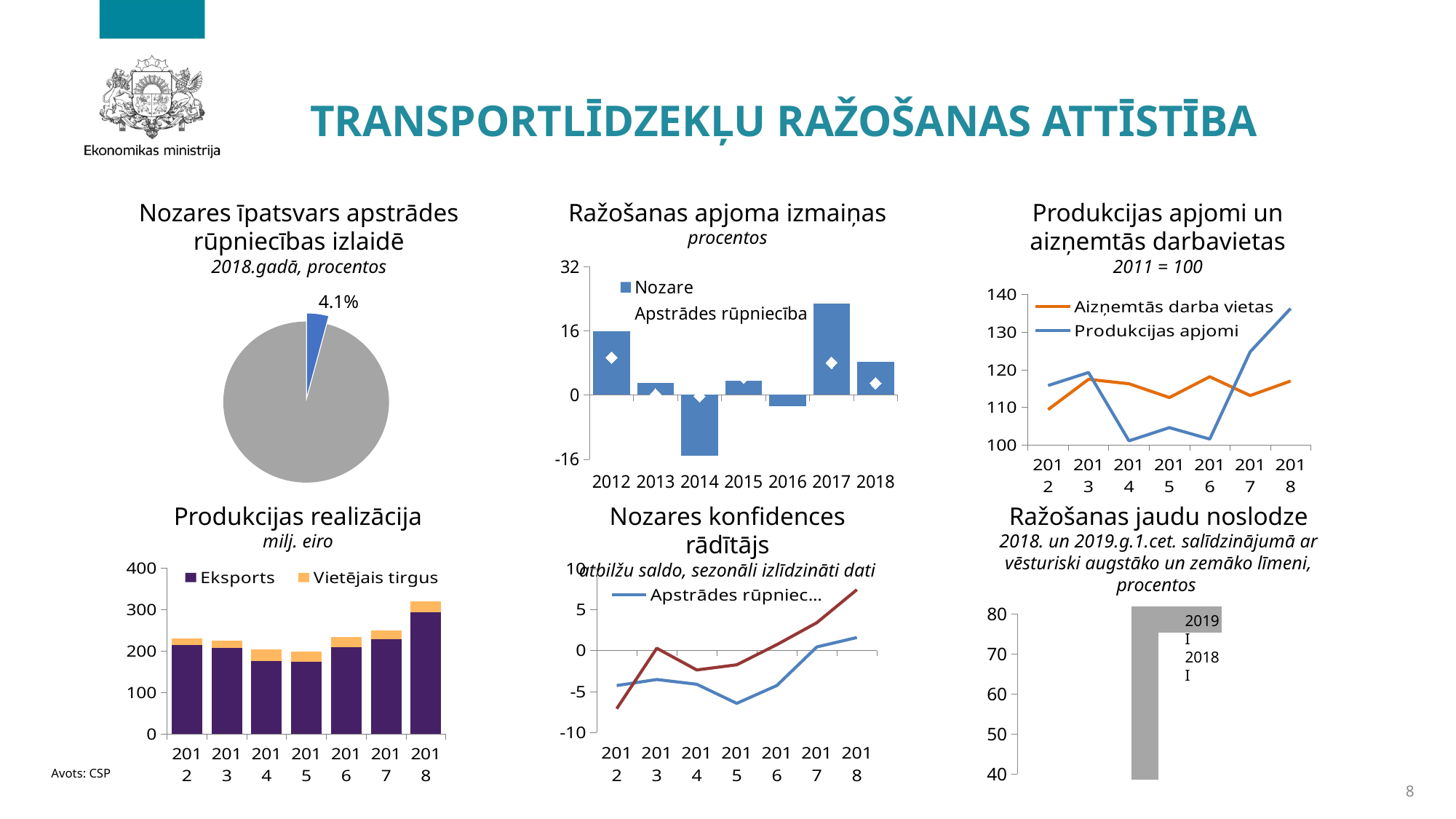
In the chart 'Ražošanas apjoma izmaiņas', how many years are shown on the x axis? 7 In the chart 'Produkcijas apjomi un aizņemtās darbavietas', which series has the higher value in 2018? Produkcijas apjomi In the chart 'Ražošanas apjoma izmaiņas', which year has the lowest Nozare bar? 2014 In the chart 'Ražošanas apjoma izmaiņas', is the Nozare value for 2017 greater or less than 16? greater In the pie chart 'Nozares īpatsvars apstrādes rūpniecības izlaidē', what value is shown for the blue slice? 4.1% In the chart 'Produkcijas realizācija', which year has the highest total bar? 2018 What kind of chart is 'Nozares konfidences rādītājs'? Line chart In the chart 'Produkcijas apjomi un aizņemtās darbavietas', is the Produkcijas apjomi value for 2018 greater or less than 130? greater In the chart 'Produkcijas apjomi un aizņemtās darbavietas', how many series does the legend list? 2 In the chart 'Ražošanas apjoma izmaiņas', which year has the highest Nozare bar? 2017 In the chart 'Produkcijas realizācija', is the Eksports value for 2018 greater or less than 200? greater What kind of chart is 'Produkcijas realizācija'? Stacked bar chart